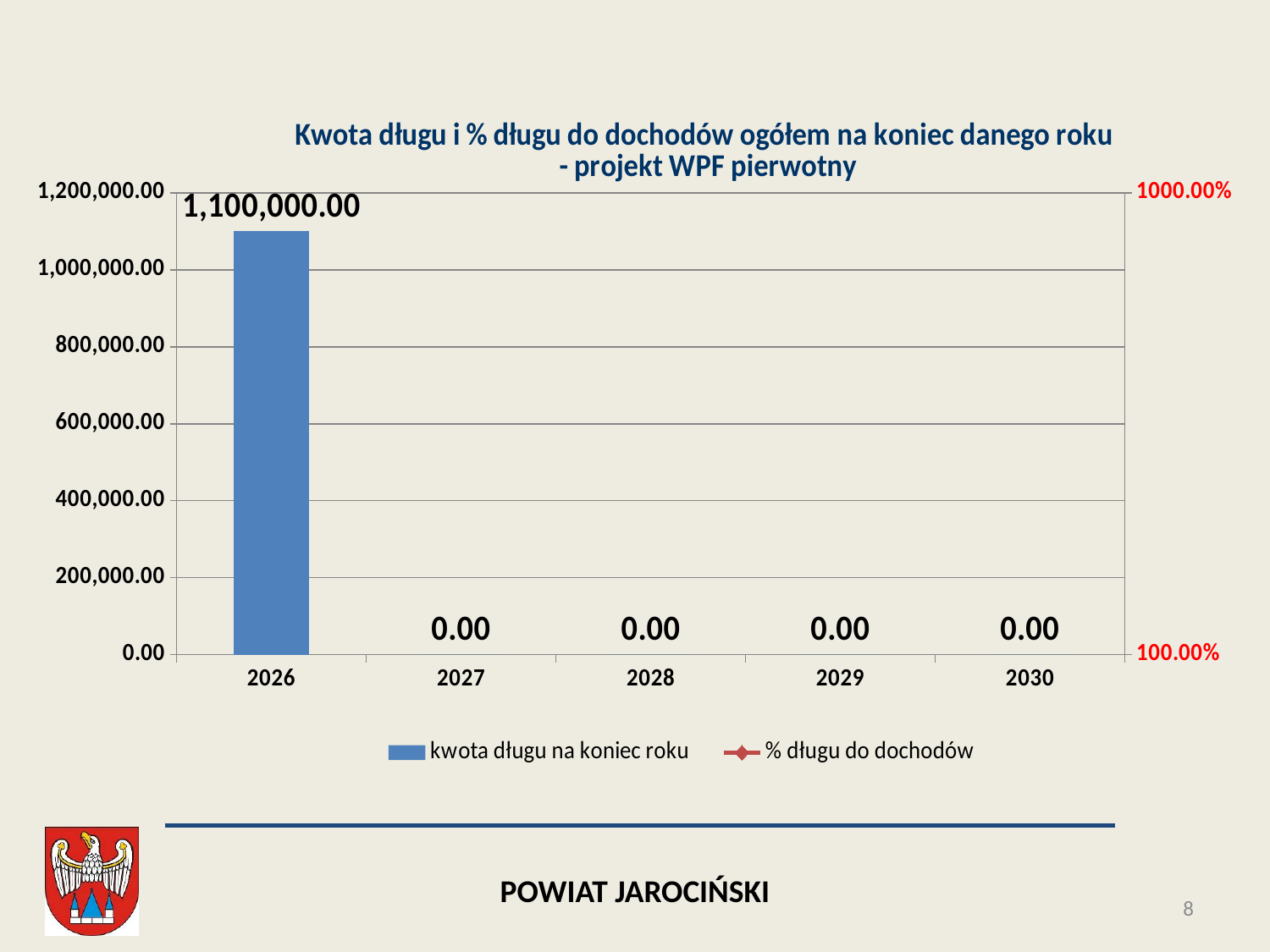
What is the value of 'kwota długu na koniec roku' for 2028? 0.00 What is the value of 'kwota długu na koniec roku' for 2026? 1,100,000.00 How many years are shown on the x axis? 5 What kind of chart is used to show 'kwota długu na koniec roku'? bar chart Do the 'kwota długu na koniec roku' values rise or fall from 2026 to 2027? fall How many series does the legend list? 2 What is the difference between the 'kwota długu na koniec roku' values for 2026 and 2027? 1,100,000.00 Is the value for 2026 greater or less than 1,000,000.00? greater Which is larger, the 'kwota długu na koniec roku' value for 2026 or for 2029? 2026 Which year has the highest value of 'kwota długu na koniec roku'? 2026 What is the value of 'kwota długu na koniec roku' for 2030? 0.00 What is the title of the chart? Kwota długu i % długu do dochodów ogółem na koniec danego roku - projekt WPF pierwotny